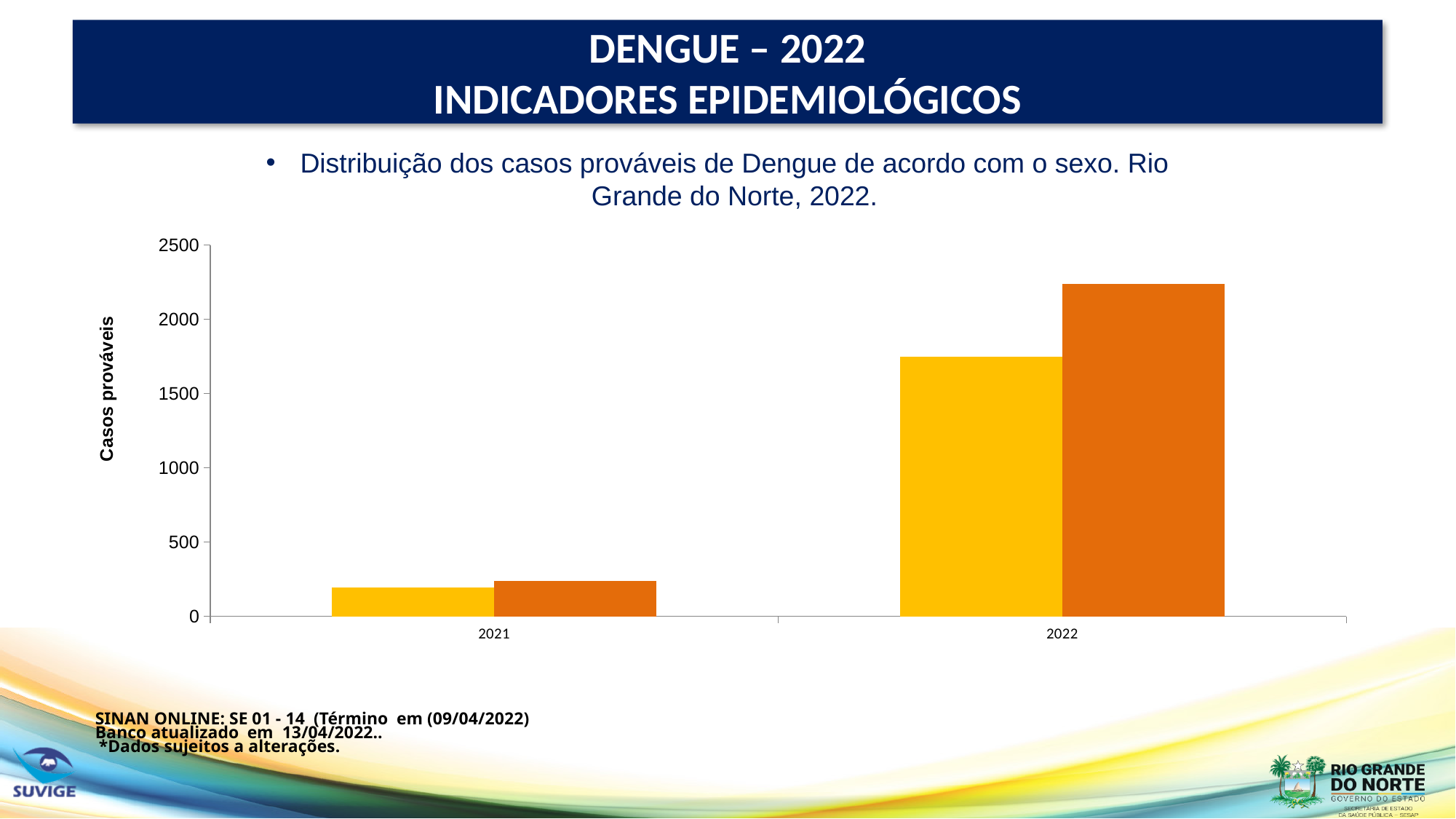
What kind of chart is shown on the slide? bar chart What is the highest value shown on the vertical axis of the chart? 2500 Is the value of the yellow bar for 2022 greater or less than 1500? greater Is the value of the yellow bar for 2022 greater or less than 2000? less Is the value of the orange bar for 2021 greater or less than 500? less How many categories (years) are shown on the x axis of the chart? 2 What is the label of the vertical axis of the chart? Casos prováveis In 2022, which bar is taller, the yellow bar or the orange bar? orange bar Do the values rise or fall from 2021 to 2022? rise Which year has the highest bar in the chart? 2022